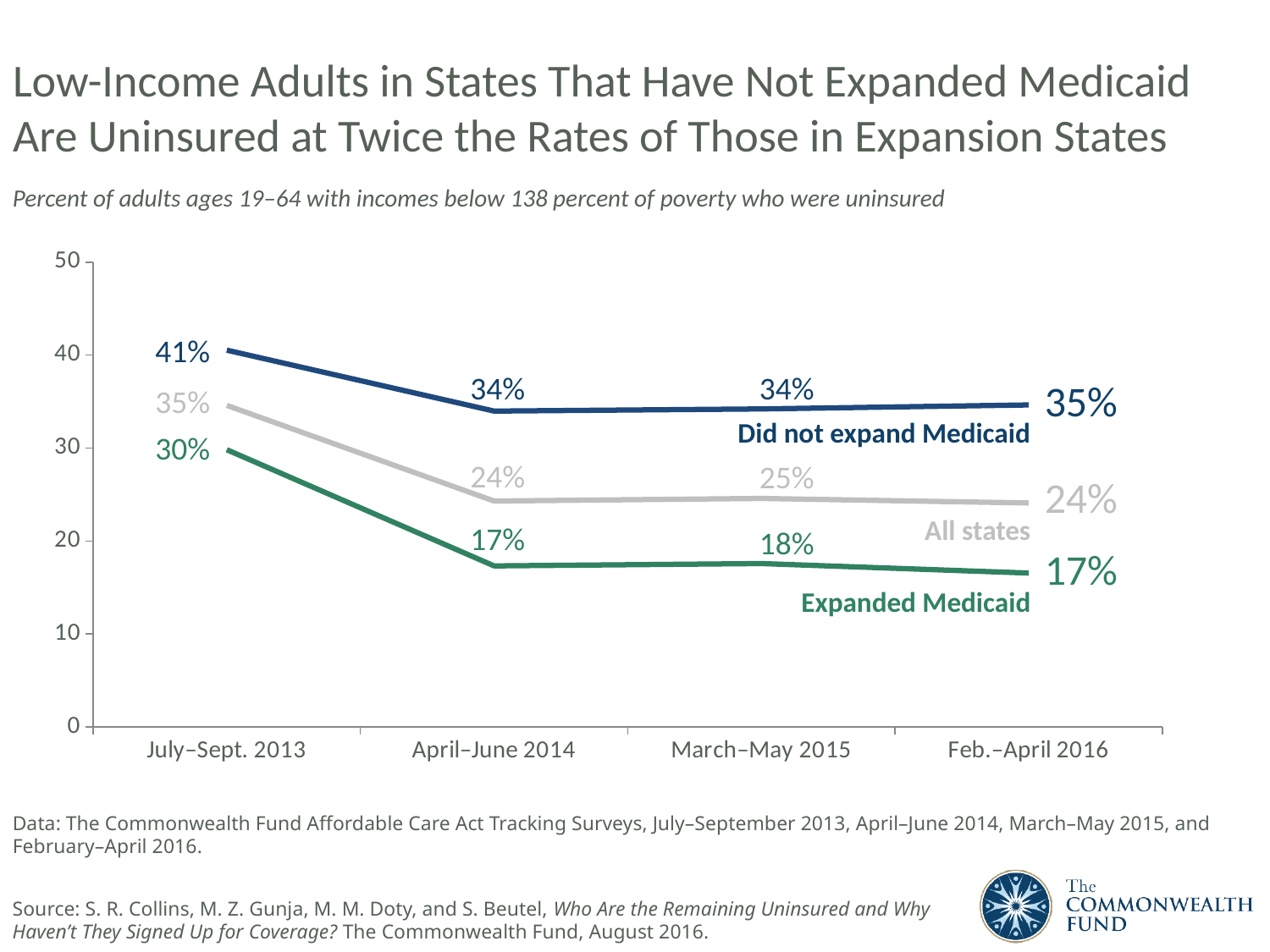
What was the uninsured rate for all states in March–May 2015? 25% How many time periods are shown on the x axis? 4 Which series had the highest uninsured rate in April–June 2014? Did not expand Medicaid How many data series are plotted on the chart? 3 What is the difference between the uninsured rates for states that did not expand Medicaid and states that expanded Medicaid in Feb.–April 2016? 18 percentage points What was the uninsured rate for adults in states that expanded Medicaid in Feb.–April 2016? 17% Which series had the lowest uninsured rate in July–Sept. 2013? Expanded Medicaid What kind of chart is shown on the slide? Line chart Did the uninsured rate for all states rise or fall from July–Sept. 2013 to Feb.–April 2016? Fall What was the uninsured rate for adults in states that did not expand Medicaid in July–Sept. 2013? 41% By how many percentage points did the uninsured rate for states that expanded Medicaid fall from July–Sept. 2013 to April–June 2014? 13 percentage points